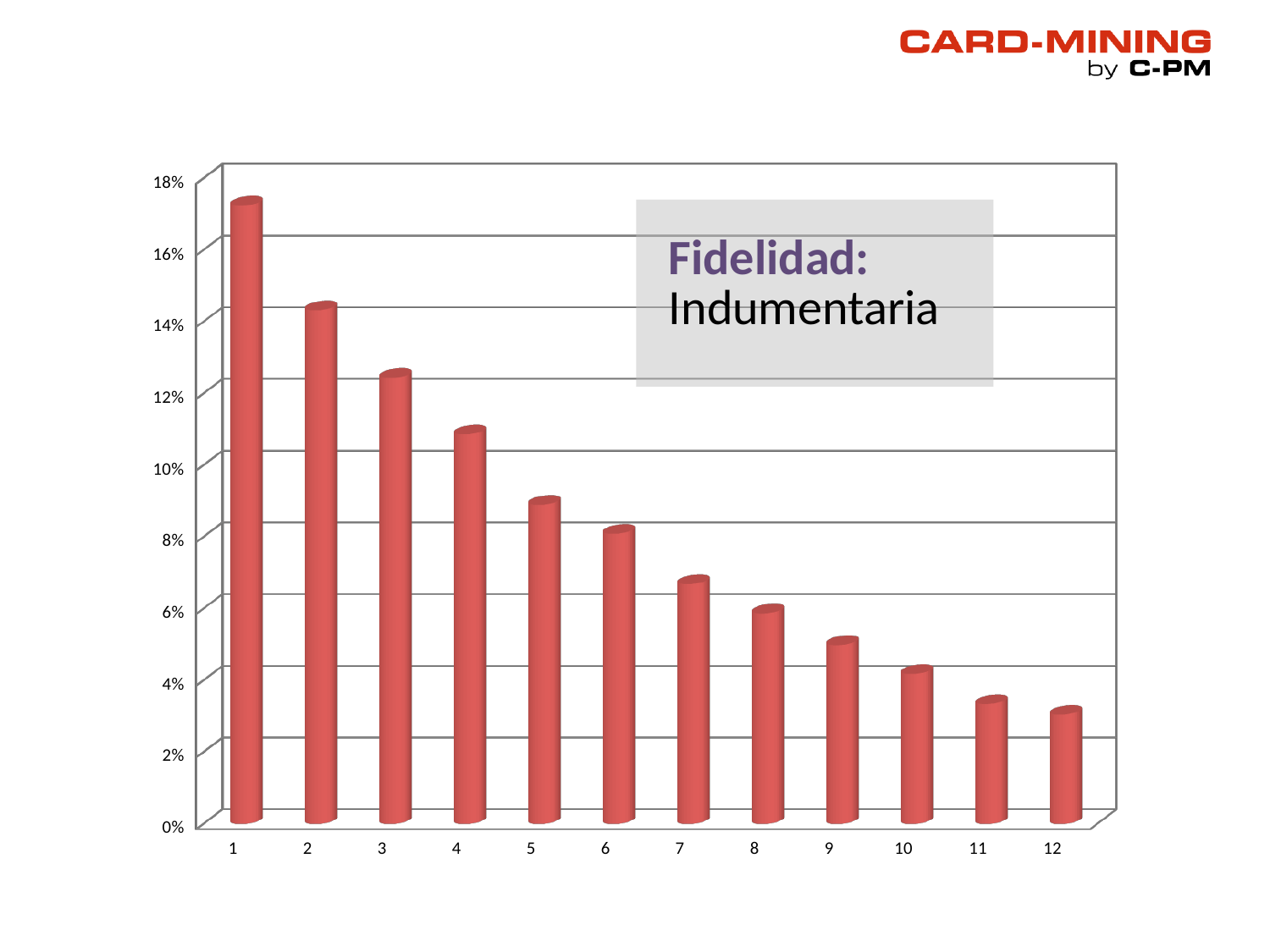
How many categories are plotted on the x axis? 12 Is the value for category 5 greater or less than 10%? less Is the value for category 1 greater or less than 16%? greater Is the value for category 11 greater or less than 4%? less Do the values rise or fall as you move from category 1 to category 12? fall What title is shown in the box on the chart? Fidelidad: Indumentaria Which category has the lowest value? 12 What kind of chart is shown on the slide? bar chart Which has the larger value, category 3 or category 5? category 3 Which category has the highest value? 1